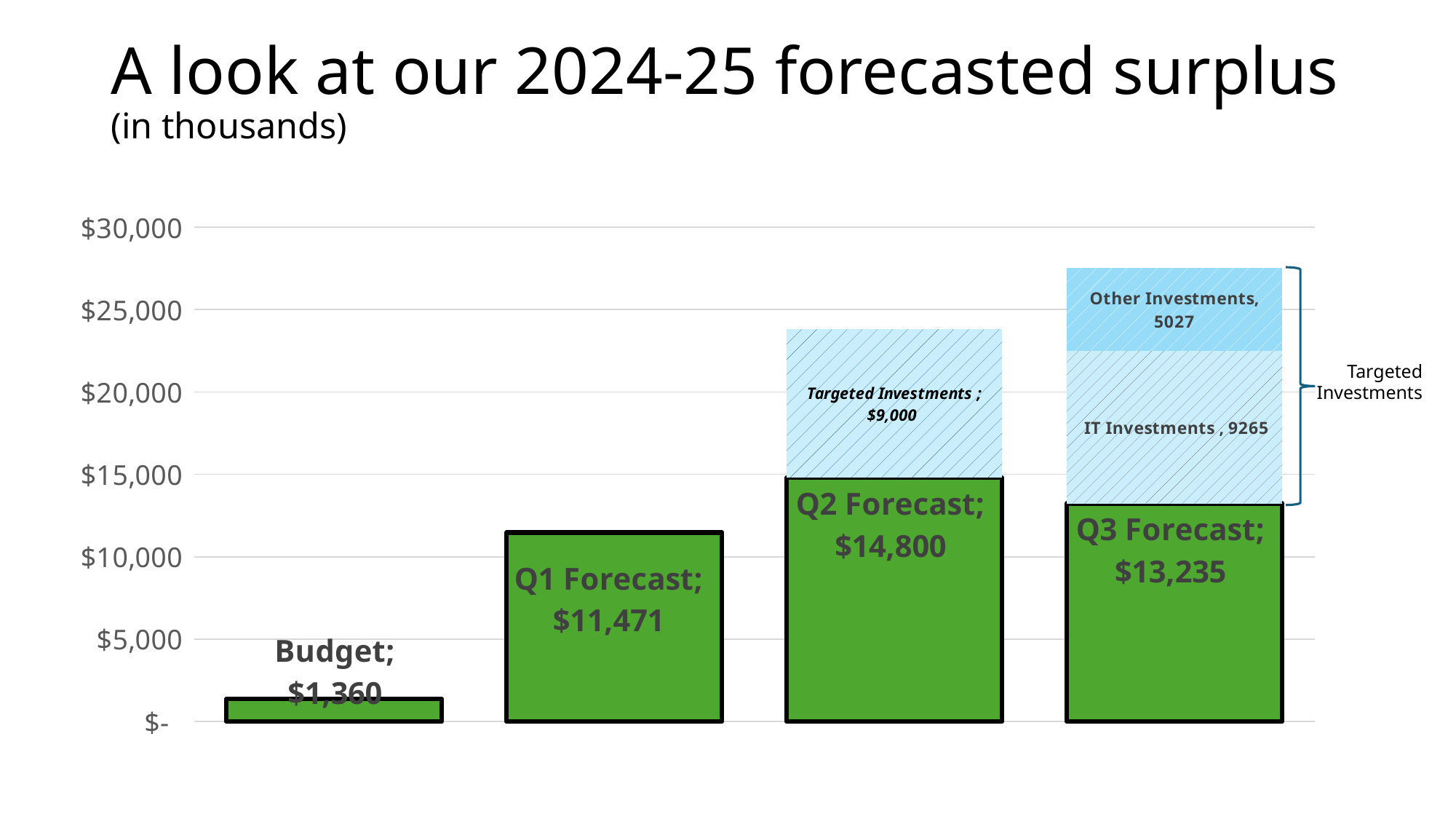
What is the value of the Other Investments segment on the Q3 Forecast bar? 5027 What is the value shown for Q2 Forecast? $14,800 What is the value of the Budget bar? $1,360 What is the difference between the Q2 Forecast and Q1 Forecast values? $3,329 What is the value shown for Q1 Forecast? $11,471 What kind of chart is shown on the slide? Bar chart What is the total of the Q3 Forecast stacked bar, including IT Investments and Other Investments? 27,527 What is the value shown for Q3 Forecast? $13,235 Which of the green forecast/budget values is the highest? Q2 Forecast What is the value of the Targeted Investments segment stacked on the Q2 Forecast bar? $9,000 What is the value of the IT Investments segment on the Q3 Forecast bar? 9265 Which bar has the lowest green value? Budget